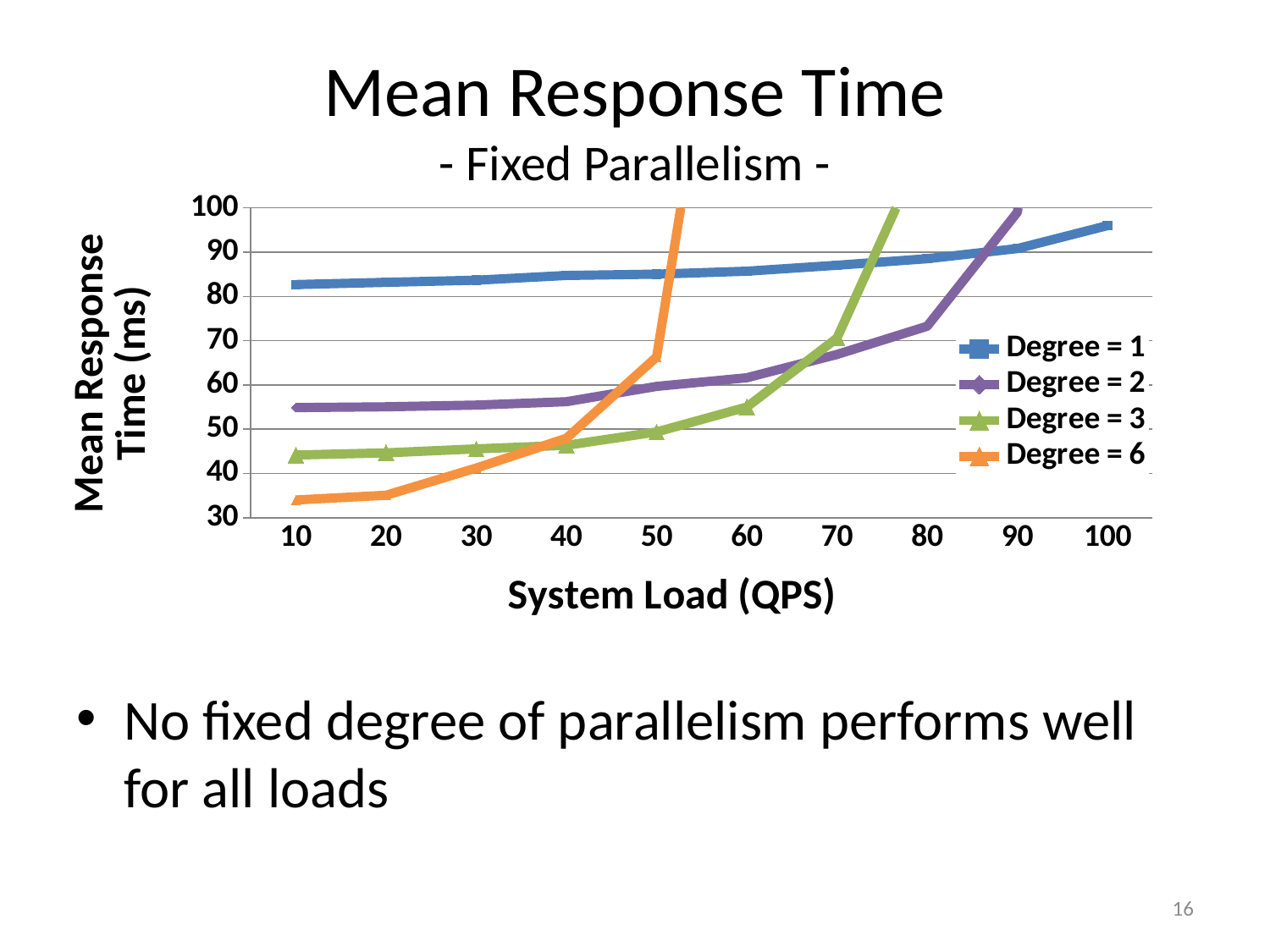
Is the mean response time for Degree = 6 at a system load of 10 QPS greater or less than 40? less Is the mean response time for Degree = 2 at a system load of 80 QPS greater or less than 70? greater What is the title of the x axis? System Load (QPS) At a system load of 10 QPS, which series has the highest mean response time? Degree = 1 Is the mean response time for Degree = 3 at a system load of 10 QPS greater or less than 40? greater How many system load values are marked on the x axis? 10 At a system load of 60 QPS, which has the higher mean response time, Degree = 2 or Degree = 3? Degree = 2 How many series does the legend list? 4 At a system load of 10 QPS, which series has the lowest mean response time? Degree = 6 Does the mean response time for Degree = 6 rise or fall as system load increases? rise What kind of chart is shown on the slide? line chart